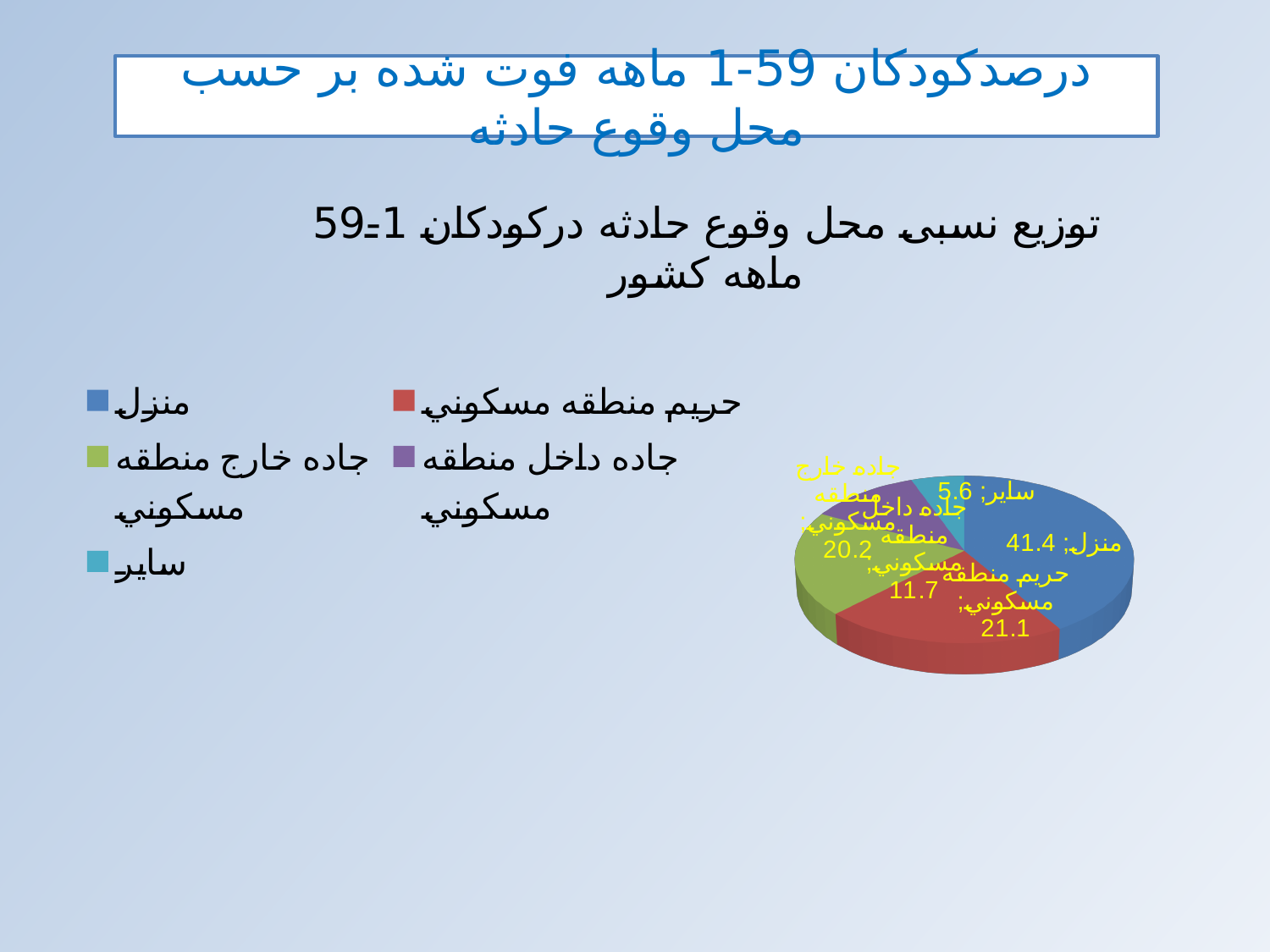
What is the value for جاده داخل منطقه مسکونی in the pie chart? 11.7 What is the value for منزل in the pie chart? 41.4 Which category has the smallest slice in the pie chart? سایر What type of chart is shown on the slide? pie chart What is the value for سایر in the pie chart? 5.6 What is the value for حریم منطقه مسکونی in the pie chart? 21.1 How many categories does the pie chart have? 5 Which category has the largest slice in the pie chart? منزل Which is larger, the value for جاده خارج منطقه مسکونی or جاده داخل منطقه مسکونی? جاده خارج منطقه مسکونی What is the difference between the values for منزل and حریم منطقه مسکونی? 20.3 How many entries does the legend list? 5 What is the value for جاده خارج منطقه مسکونی in the pie chart? 20.2